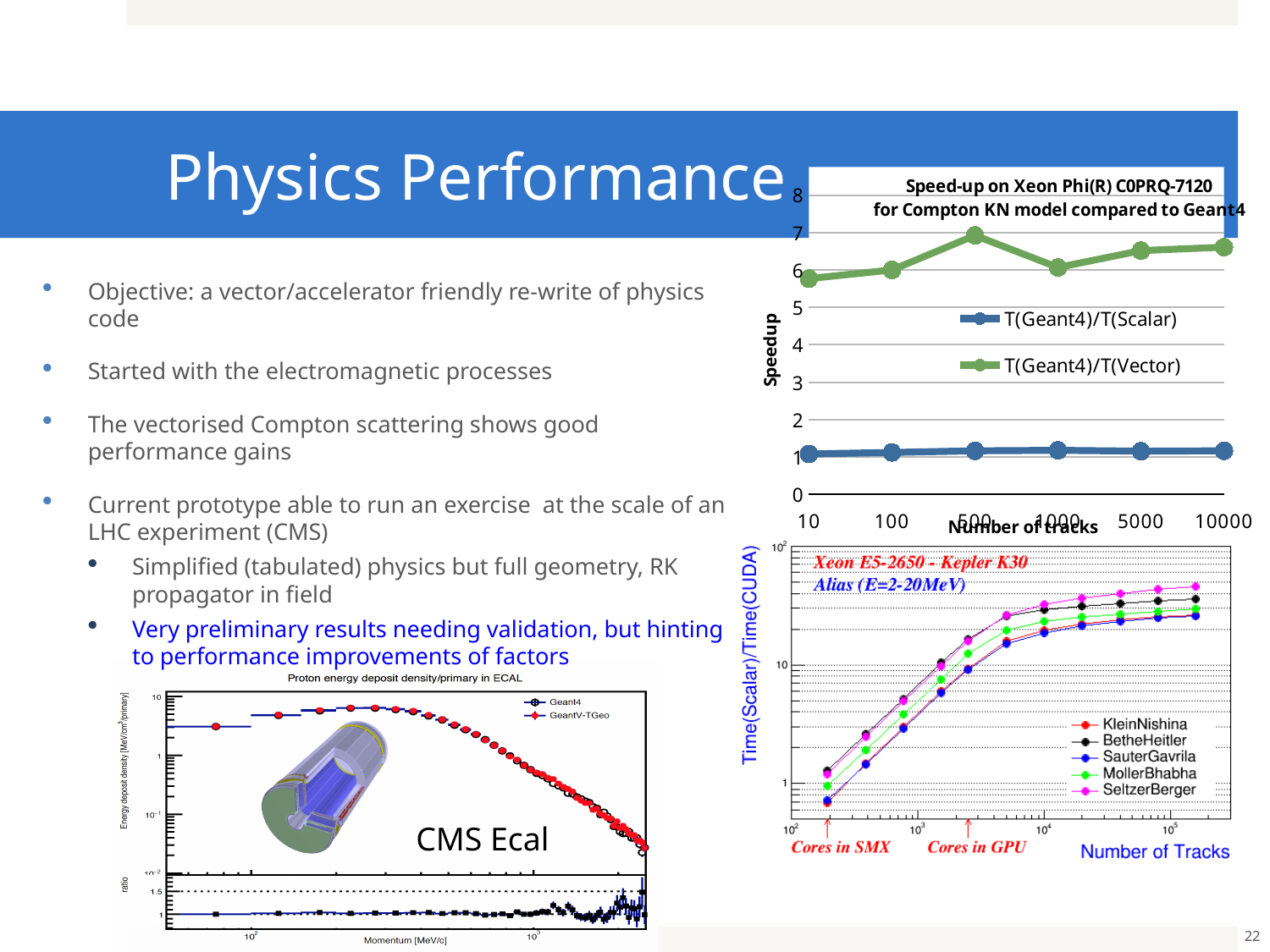
In the top-right speed-up chart, how many points are plotted for the T(Geant4)/T(Vector) series? 6 What kind of chart is the top-right chart titled "Speed-up on Xeon Phi(R) C0PRQ-7120 for Compton KN model compared to Geant4"? line chart In the top-right speed-up chart, is the T(Geant4)/T(Scalar) value at 1000 tracks greater or less than 2? less In the top-right speed-up chart, what is the label of the y axis? Speedup In the top-right speed-up chart, is the T(Geant4)/T(Vector) value at 500 tracks greater or less than 6? greater In the bottom-left chart titled "Proton energy deposit density/primary in ECAL", how many series does the legend list? 2 In the top-right speed-up chart, what are the two legend entries? T(Geant4)/T(Scalar) and T(Geant4)/T(Vector) In the top-right speed-up chart, which series has the larger value at 10000 tracks, T(Geant4)/T(Scalar) or T(Geant4)/T(Vector)? T(Geant4)/T(Vector) In the top-right speed-up chart, at which number of tracks is the T(Geant4)/T(Vector) speedup highest? 500 In the bottom-right chart of Time(Scalar)/Time(CUDA) versus Number of Tracks, how many series does the legend list? 5 In the bottom-right chart of Time(Scalar)/Time(CUDA) versus Number of Tracks, which series has the highest value at the largest number of tracks? SeltzerBerger In the top-right speed-up chart, how many series does the legend list? 2